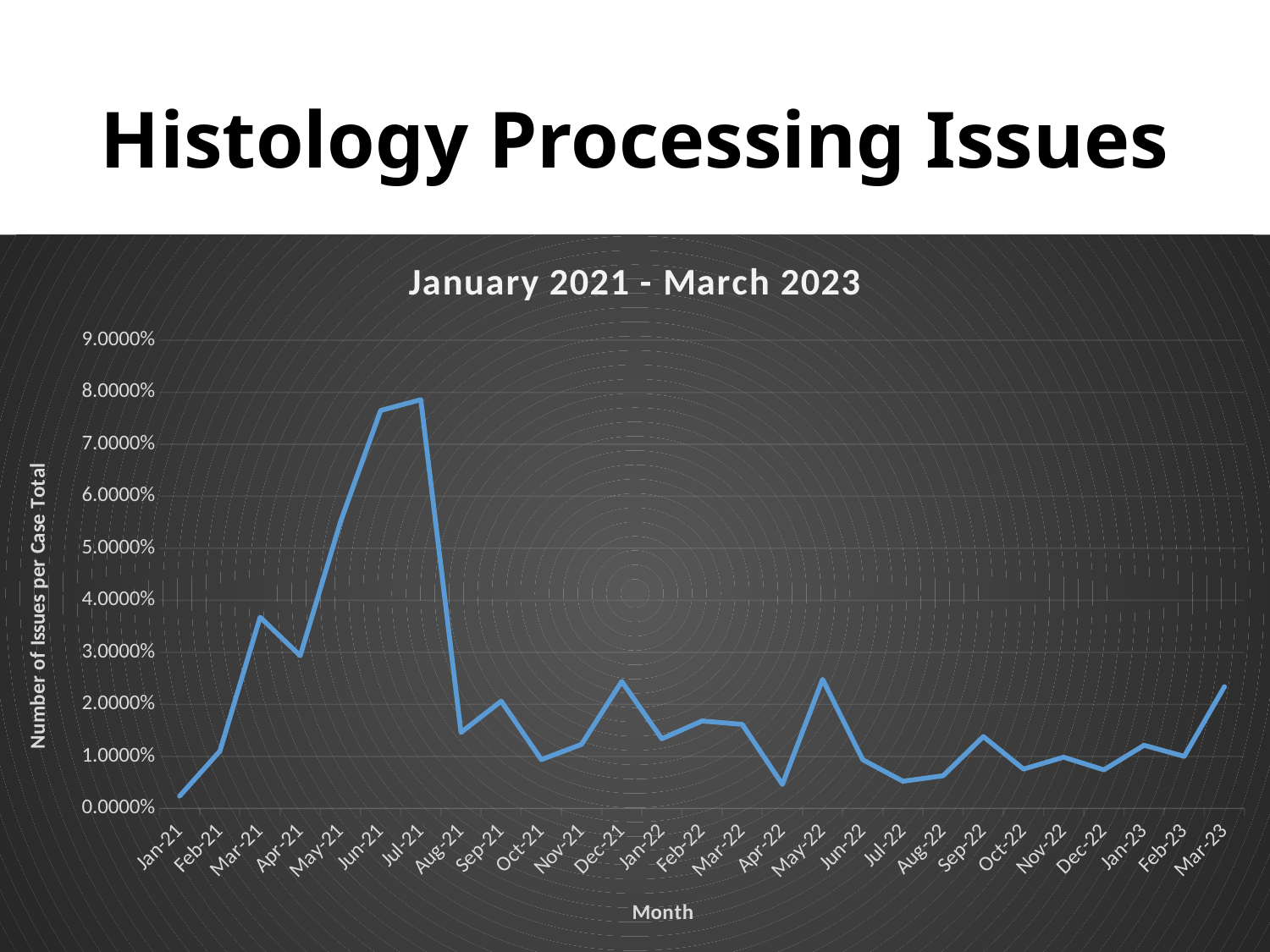
Which month has the highest value for Number of Issues per Case Total? Jul-21 Which is larger, the value for May-22 or the value for Jun-22? May-22 Do the values rise or fall from Jan-21 to Jul-21? rise Is the value for Mar-21 greater or less than 3.0000%? greater What is the title of the chart? January 2021 - March 2023 How many months are plotted along the x axis? 27 Which is larger, the value for Mar-21 or the value for Apr-21? Mar-21 What kind of chart is shown on the slide? Line chart Is the value for Jun-21 greater or less than 7.0000%? greater Is the value for Apr-22 greater or less than 1.0000%? less Which month has the lowest value for Number of Issues per Case Total? Jan-21